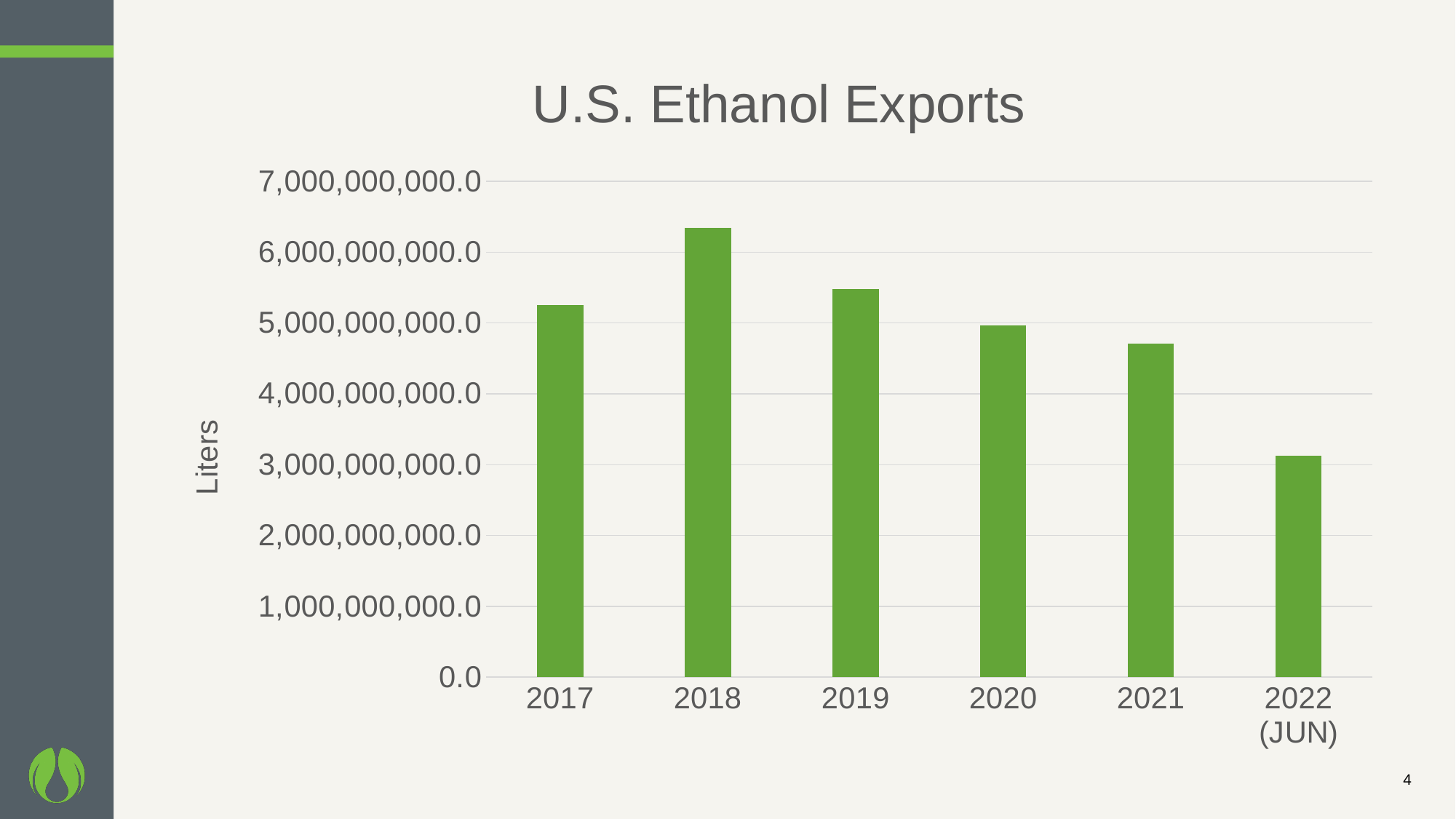
What is the label on the vertical axis of the chart? Liters Is the value for 2021 greater or less than 5,000,000,000.0? less Is the value for 2017 greater or less than 5,000,000,000.0? greater Which is larger, the value for 2017 or the value for 2019? 2019 What is the title of the chart? U.S. Ethanol Exports Is the value for 2018 greater or less than 6,000,000,000.0? greater Which year has the highest ethanol exports? 2018 How many bars (categories) are plotted in the chart? 6 Do the values rise or fall from 2018 to 2022 (JUN)? fall What type of chart is shown on the slide? Bar chart Which category has the lowest ethanol exports? 2022 (JUN)